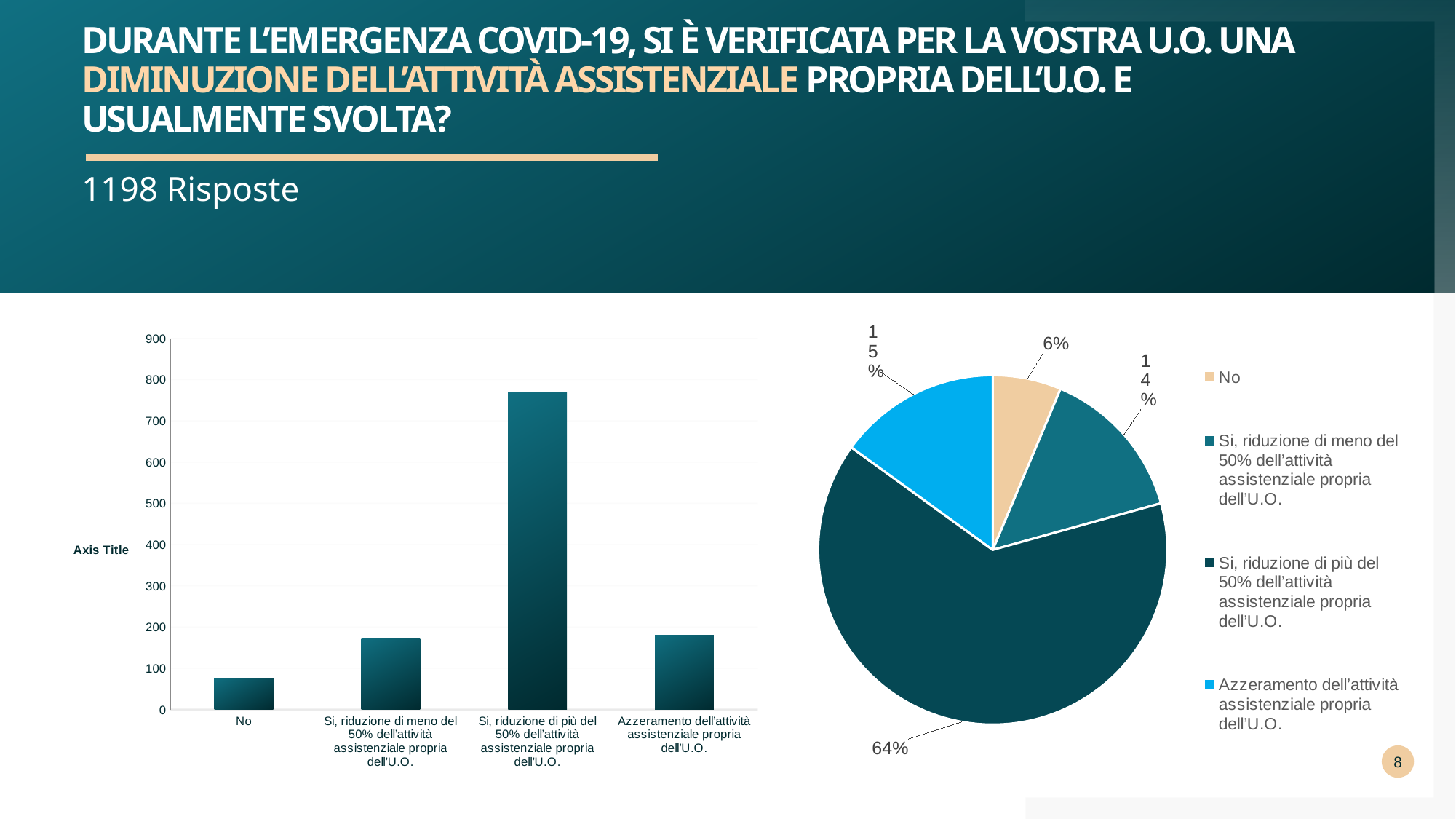
What kind of chart is the chart on the left of the slide? bar chart How many entries does the legend of the pie chart on the right list? 4 In the bar chart on the left, which category has the highest bar? Si, riduzione di più del 50% dell'attività assistenziale propria dell'U.O. In the bar chart on the left, is the value for 'Si, riduzione di meno del 50% dell'attività assistenziale propria dell'U.O.' greater or less than 200? less In the pie chart on the right, what share is shown for 'Azzeramento dell'attività assistenziale propria dell'U.O.'? 15% In the pie chart on the right, what is the difference in percentage points between the largest slice (64%) and the 'Azzeramento' slice (15%)? 49 percentage points In the bar chart on the left, which category has the lowest bar? No In the bar chart on the left, is the value for 'Si, riduzione di più del 50% dell'attività assistenziale propria dell'U.O.' greater or less than 700? greater In the bar chart on the left, how many categories are shown on the x axis? 4 In the bar chart on the left, is the value for 'No' greater or less than 100? less In the pie chart on the right, what share is shown for 'No'? 6% What kind of chart is the chart on the right of the slide? pie chart